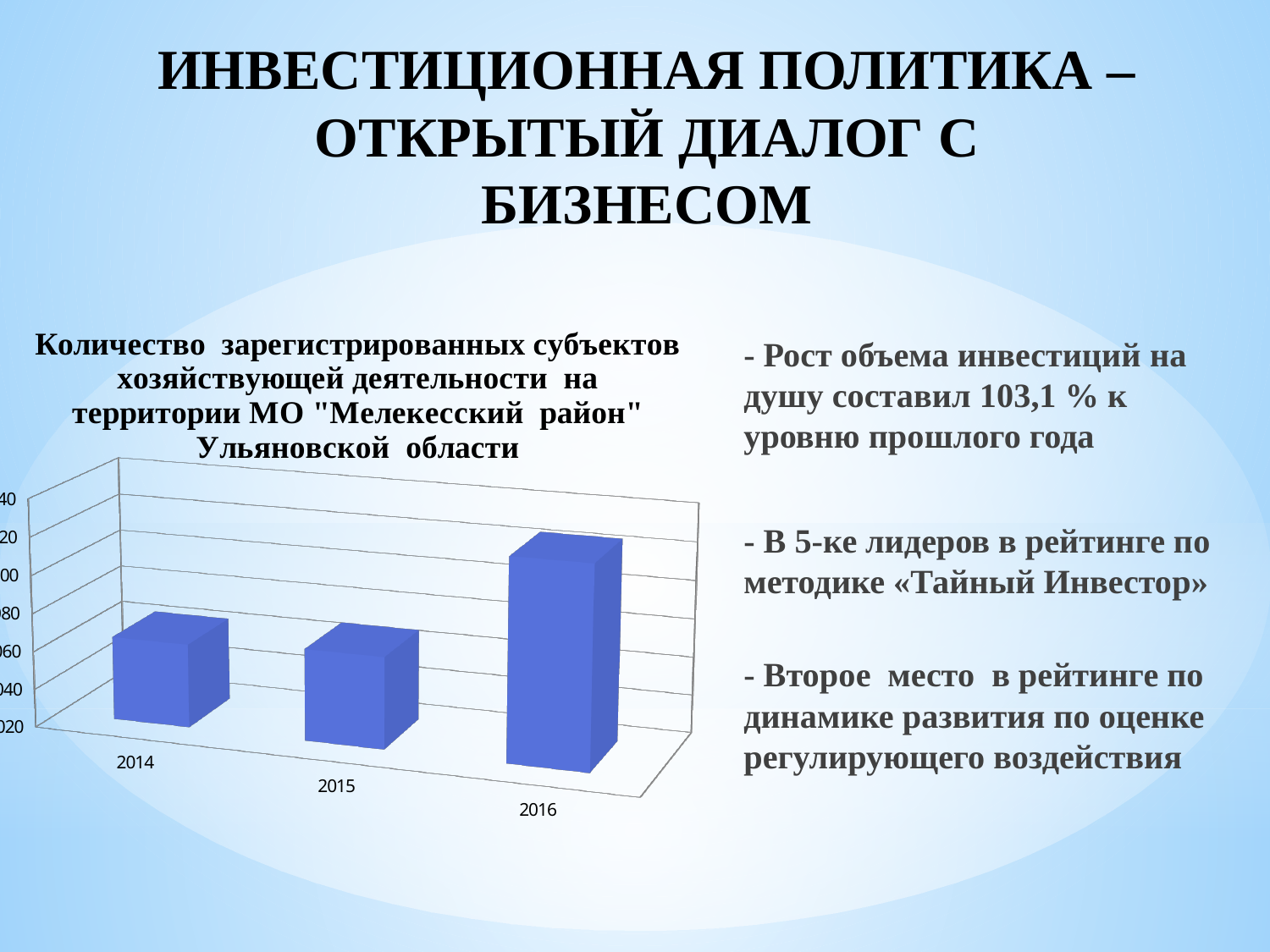
What is the first year shown on the x axis of the chart? 2014 Which is larger in the chart, the value for 2015 or the value for 2016? 2016 Which is larger in the chart, the value for 2016 or the value for 2014? 2016 What kind of chart is shown on the slide? bar chart Which year has the highest number of registered business entities in the chart? 2016 How many years (categories) are plotted in the chart? 3 What colour are the bars in the chart? blue